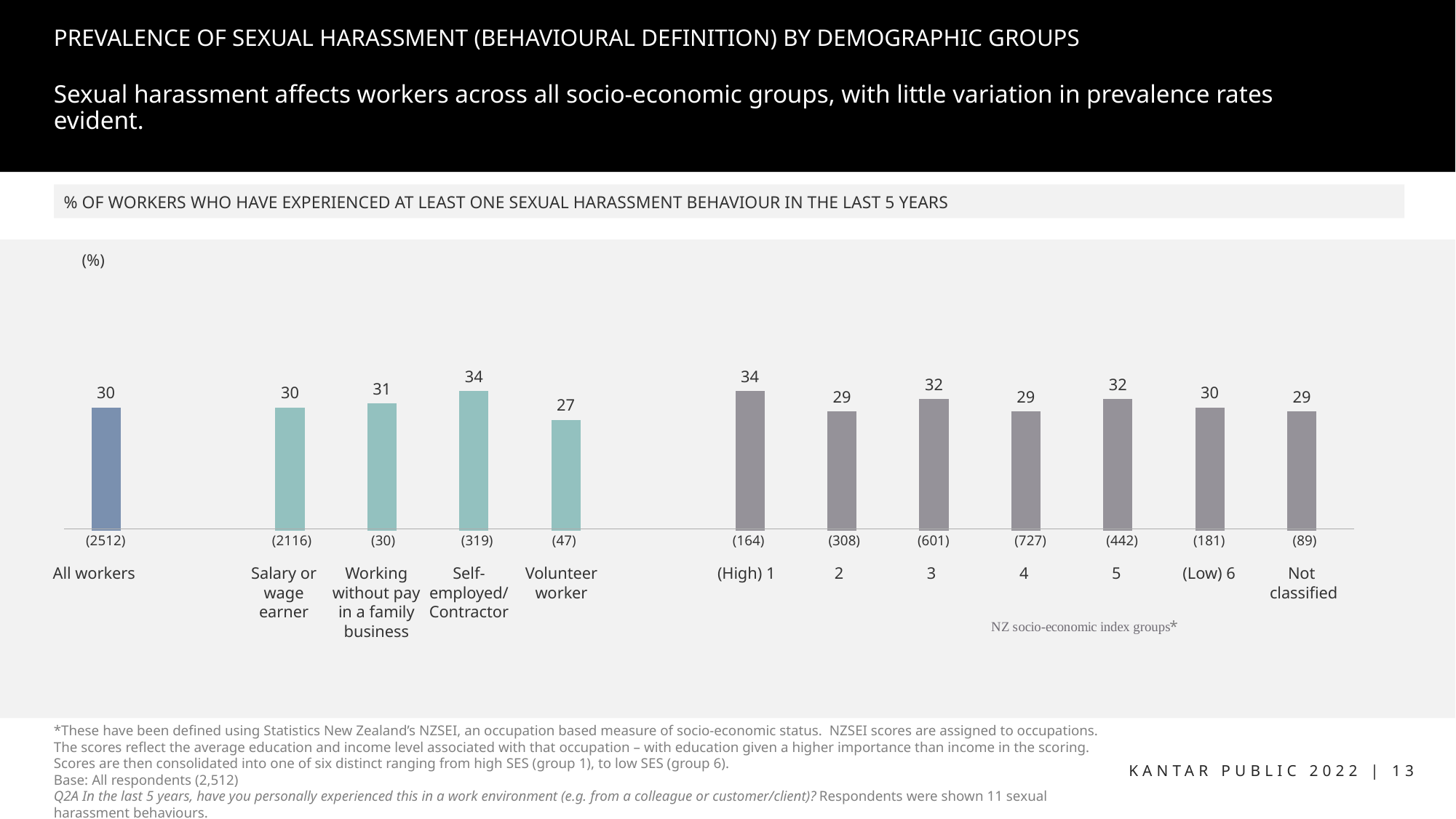
What is the base size shown under the Salary or wage earner bar? (2116) What is the value for NZ socio-economic index group 3? 32 What kind of chart is shown on the slide? Bar chart Which is larger, the value for Working without pay in a family business or the value for Volunteer worker? Working without pay in a family business What is the value for All workers? 30 What is the value for Volunteer worker? 27 What is the difference between the values for (High) 1 and (Low) 6? 4 Which category has the lowest value on the chart? Volunteer worker How many bars are plotted on the chart? 12 What is the value for Self-employed/Contractor? 34 What is the difference between the values for Self-employed/Contractor and Volunteer worker? 7 What is the title of the chart? % of workers who have experienced at least one sexual harassment behaviour in the last 5 years